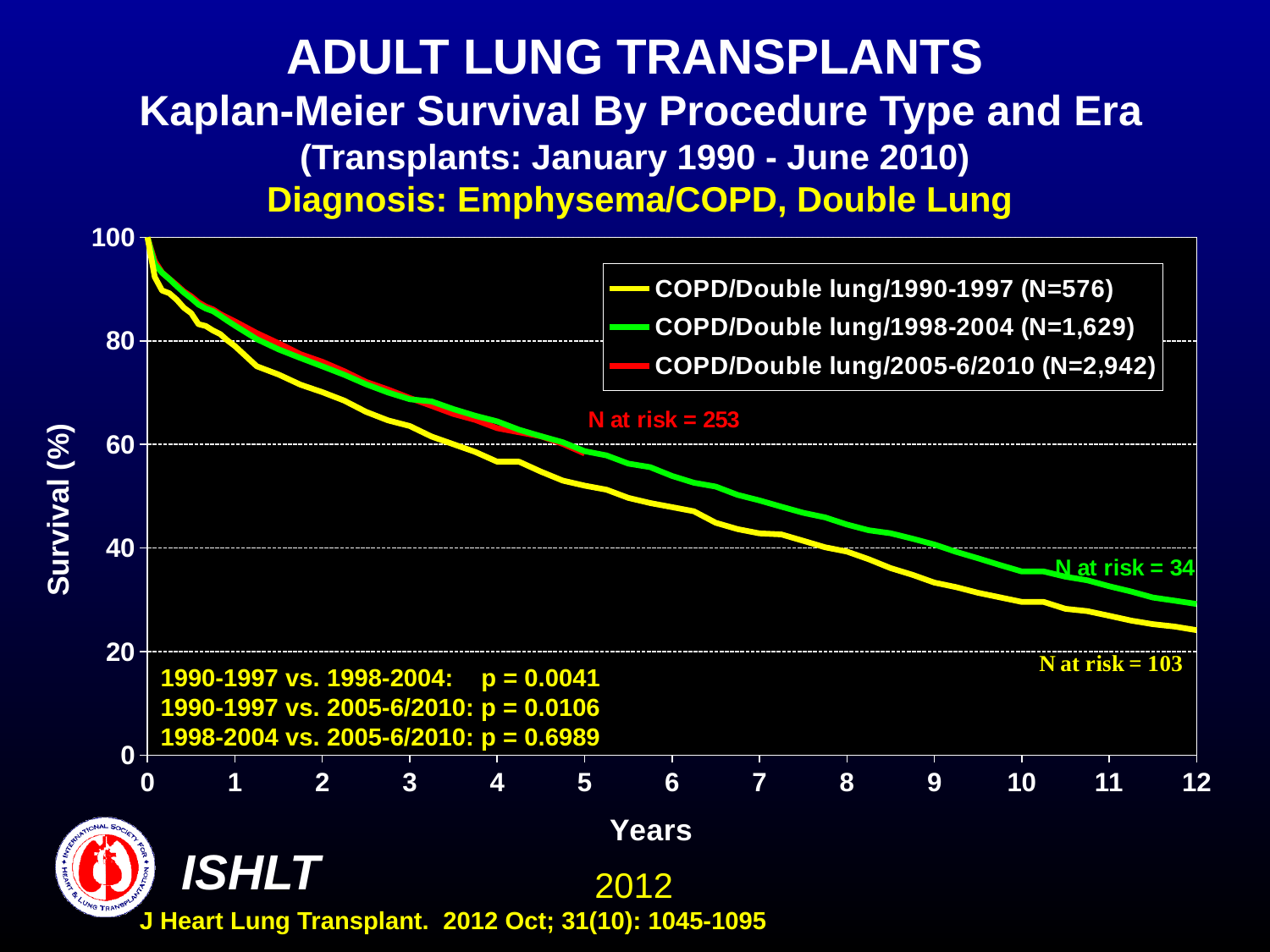
What kind of chart is shown on the slide? line chart What is the N for the COPD/Double lung/2005-6/2010 series in the legend? 2,942 Do the survival curves rise or fall as years increase? fall What is the N for the COPD/Double lung/1998-2004 series in the legend? 1,629 Is the survival for the 1990-1997 series at 6 years greater or less than 60%? less What is the p-value for 1990-1997 vs. 1998-2004? p = 0.0041 Is the survival for the 1998-2004 series at 3 years greater or less than 60%? greater At 12 years, which series has higher survival: 1990-1997 or 1998-2004? 1998-2004 What is the N at risk shown for the 1990-1997 series near the end of the curve? 103 Which series has the largest N in the legend? COPD/Double lung/2005-6/2010 What is the p-value for 1998-2004 vs. 2005-6/2010? p = 0.6989 How many series does the legend list? 3